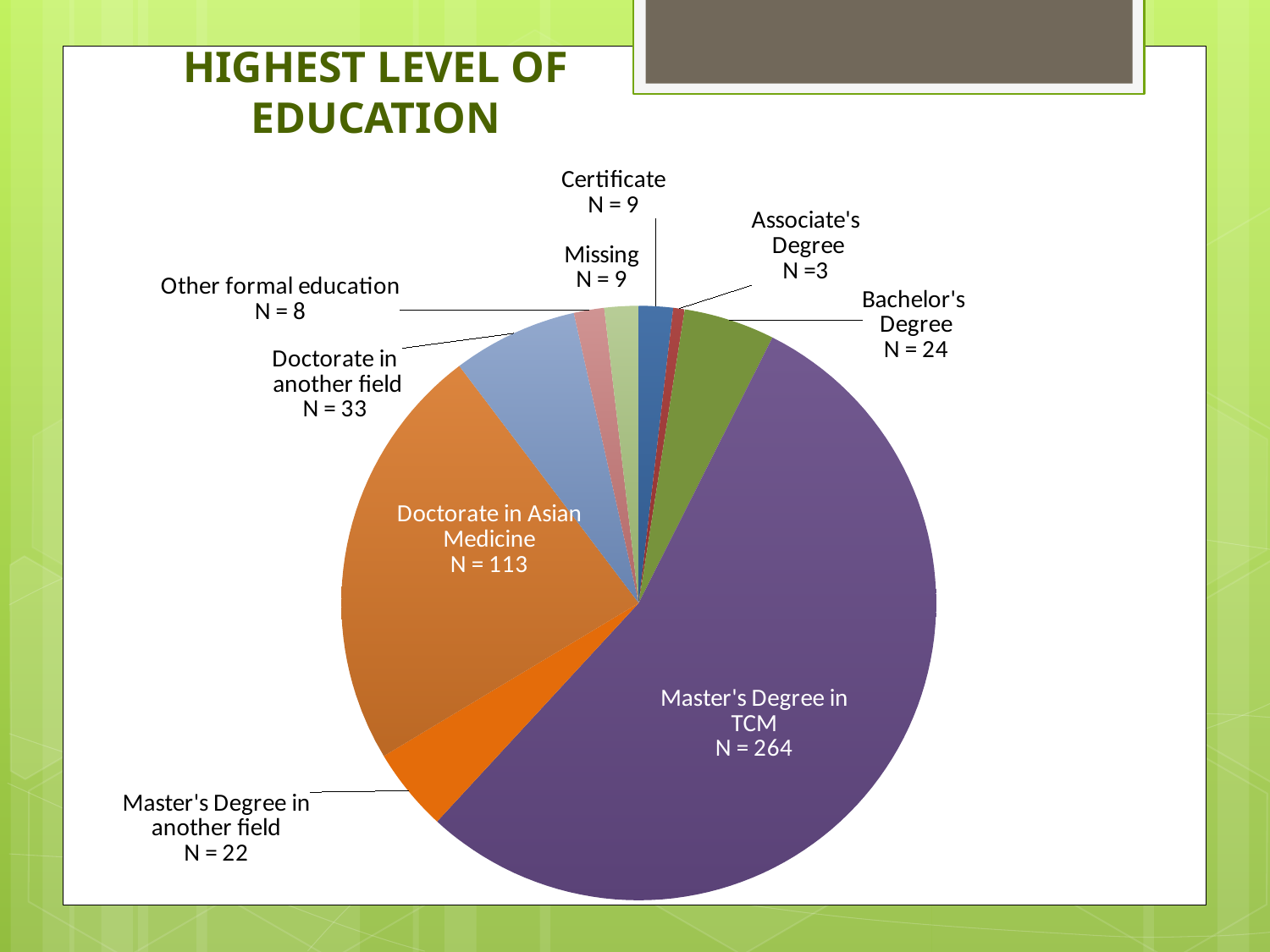
Which category has the largest slice of the pie? Master's Degree in TCM Which is larger, the N value for Doctorate in another field or for Master's Degree in another field? Doctorate in another field What is the difference between the N values for Doctorate in another field and Bachelor's Degree? 9 What is the N value for Bachelor's Degree? N = 24 What is the N value for Associate's Degree? N =3 What is the title of the chart? HIGHEST LEVEL OF EDUCATION How many categories (slices) does the pie chart have? 9 What kind of chart is shown on the slide? pie chart What is the difference between the N values for Master's Degree in TCM and Doctorate in Asian Medicine? 151 What is the N value for Master's Degree in TCM? N = 264 Which category has the smallest slice of the pie? Associate's Degree What is the N value for Doctorate in Asian Medicine? N = 113